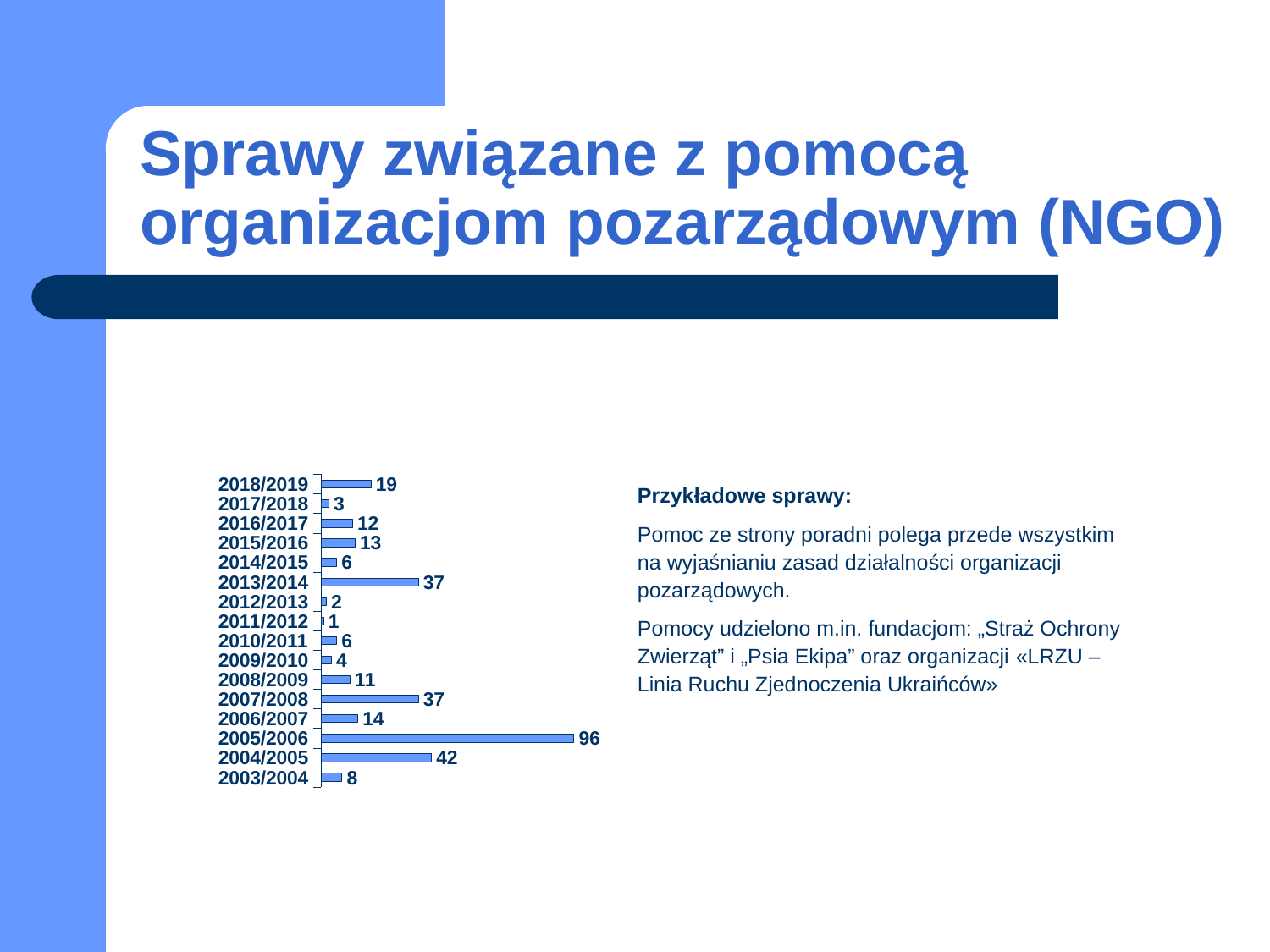
Which category has the highest value? 2005/2006 What is the difference between the values for 2018/2019 and 2017/2018? 16 What is the value for 2013/2014? 37 Which is larger, the value for 2016/2017 or the value for 2015/2016? 2015/2016 Which category has the lowest value? 2011/2012 What is the value for 2005/2006? 96 What is the difference between the values for 2005/2006 and 2004/2005? 54 What is the value for 2008/2009? 11 How many categories are shown in the chart? 16 What is the value for 2018/2019? 19 What kind of chart is shown on the slide? bar chart Which is larger, the value for 2007/2008 or the value for 2006/2007? 2007/2008